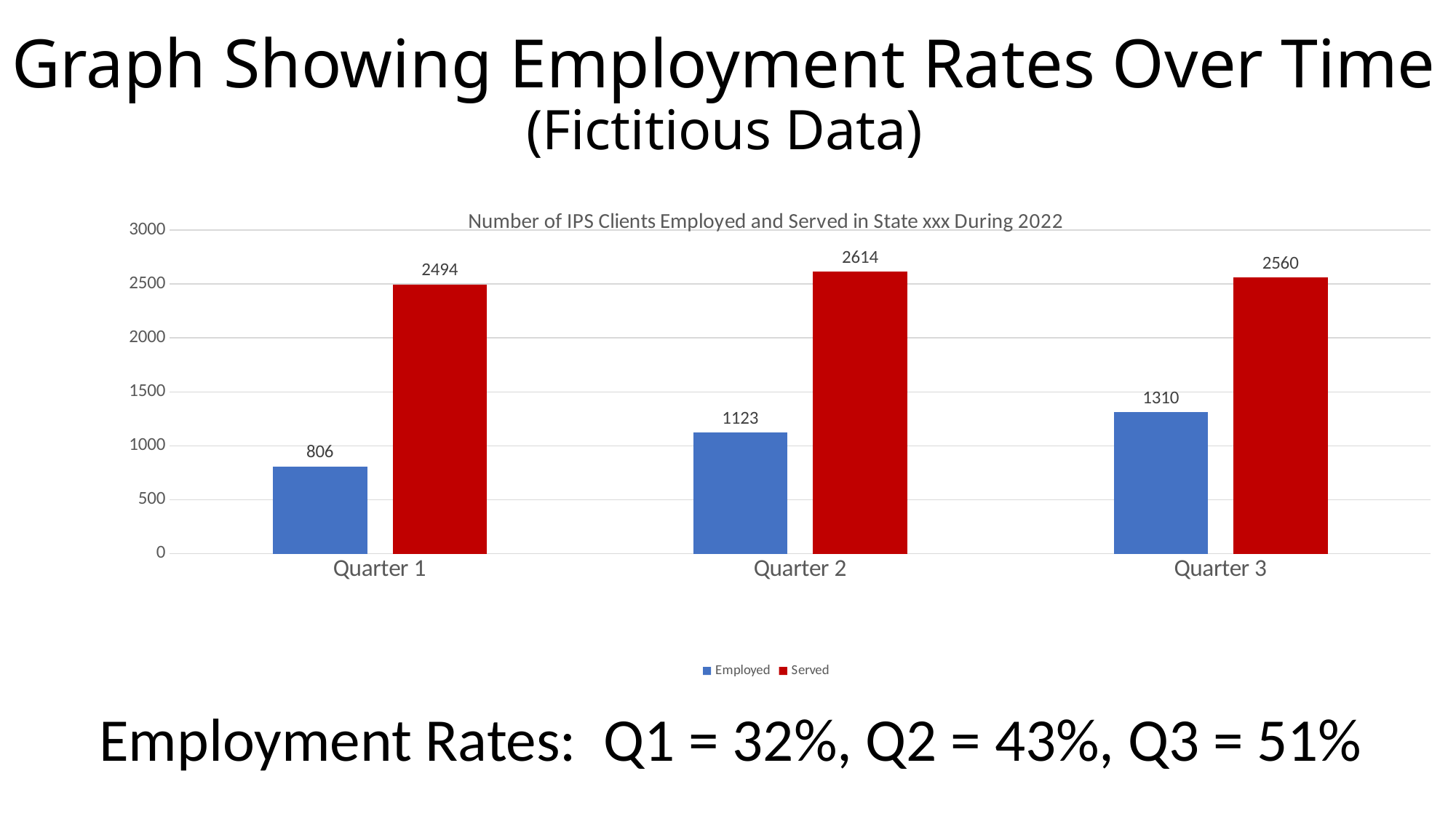
How many quarters are shown on the x axis? 3 What is the Employed value for Quarter 2? 1123 Is the Employed value for Quarter 3 greater or less than 1500? less Which is larger, the Served value for Quarter 1 or the Served value for Quarter 3? Quarter 3 How many series does the legend list? 2 What is the Employed value for Quarter 1? 806 Which quarter has the highest Served value? Quarter 2 What is the difference between the Served and Employed values in Quarter 1? 1688 Which quarter has the lowest Employed value? Quarter 1 What is the difference between the Employed values for Quarter 3 and Quarter 2? 187 What is the Served value for Quarter 3? 2560 Do the Employed values rise or fall from Quarter 1 to Quarter 3? rise